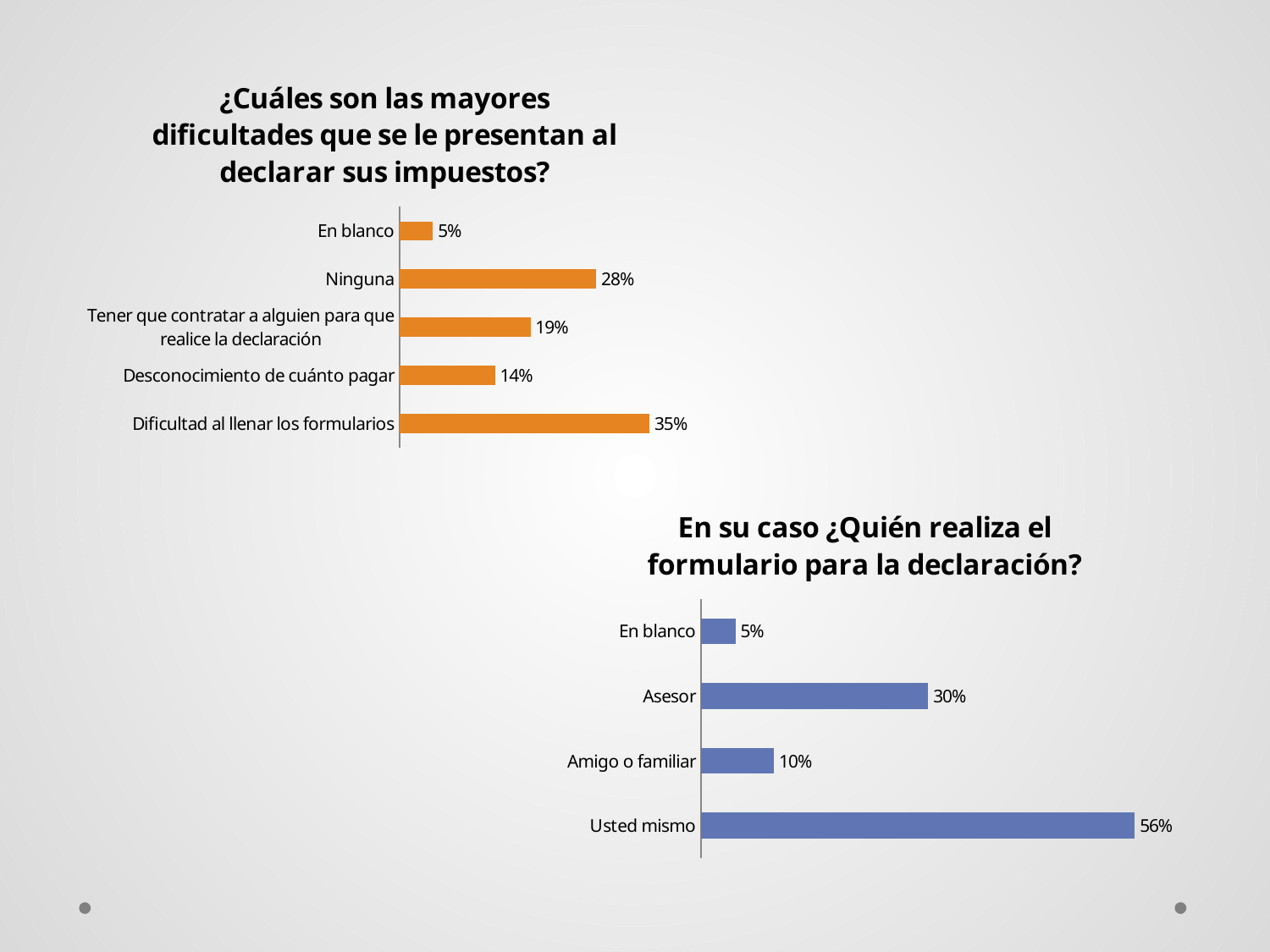
In the top chart '¿Cuáles son las mayores dificultades que se le presentan al declarar sus impuestos?', how many categories are shown? 5 In the top chart '¿Cuáles son las mayores dificultades que se le presentan al declarar sus impuestos?', what is the difference between 'Tener que contratar a alguien para que realice la declaración' and 'Desconocimiento de cuánto pagar'? 5% In the bottom chart 'En su caso ¿Quién realiza el formulario para la declaración?', what is the value for 'Usted mismo'? 56% In the top chart '¿Cuáles son las mayores dificultades que se le presentan al declarar sus impuestos?', which category has the lowest value? En blanco In the bottom chart 'En su caso ¿Quién realiza el formulario para la declaración?', what is the difference between 'Usted mismo' and 'Asesor'? 26% In the top chart '¿Cuáles son las mayores dificultades que se le presentan al declarar sus impuestos?', what is the value for 'Dificultad al llenar los formularios'? 35% In the bottom chart 'En su caso ¿Quién realiza el formulario para la declaración?', which is larger, 'Amigo o familiar' or 'Asesor'? Asesor In the top chart '¿Cuáles son las mayores dificultades que se le presentan al declarar sus impuestos?', which category has the highest value? Dificultad al llenar los formularios In the bottom chart 'En su caso ¿Quién realiza el formulario para la declaración?', how many categories are shown? 4 What type of chart is the bottom chart 'En su caso ¿Quién realiza el formulario para la declaración?'? Bar chart In the bottom chart 'En su caso ¿Quién realiza el formulario para la declaración?', what is the value for 'Asesor'? 30% In the top chart '¿Cuáles son las mayores dificultades que se le presentan al declarar sus impuestos?', what is the value for 'Ninguna'? 28%